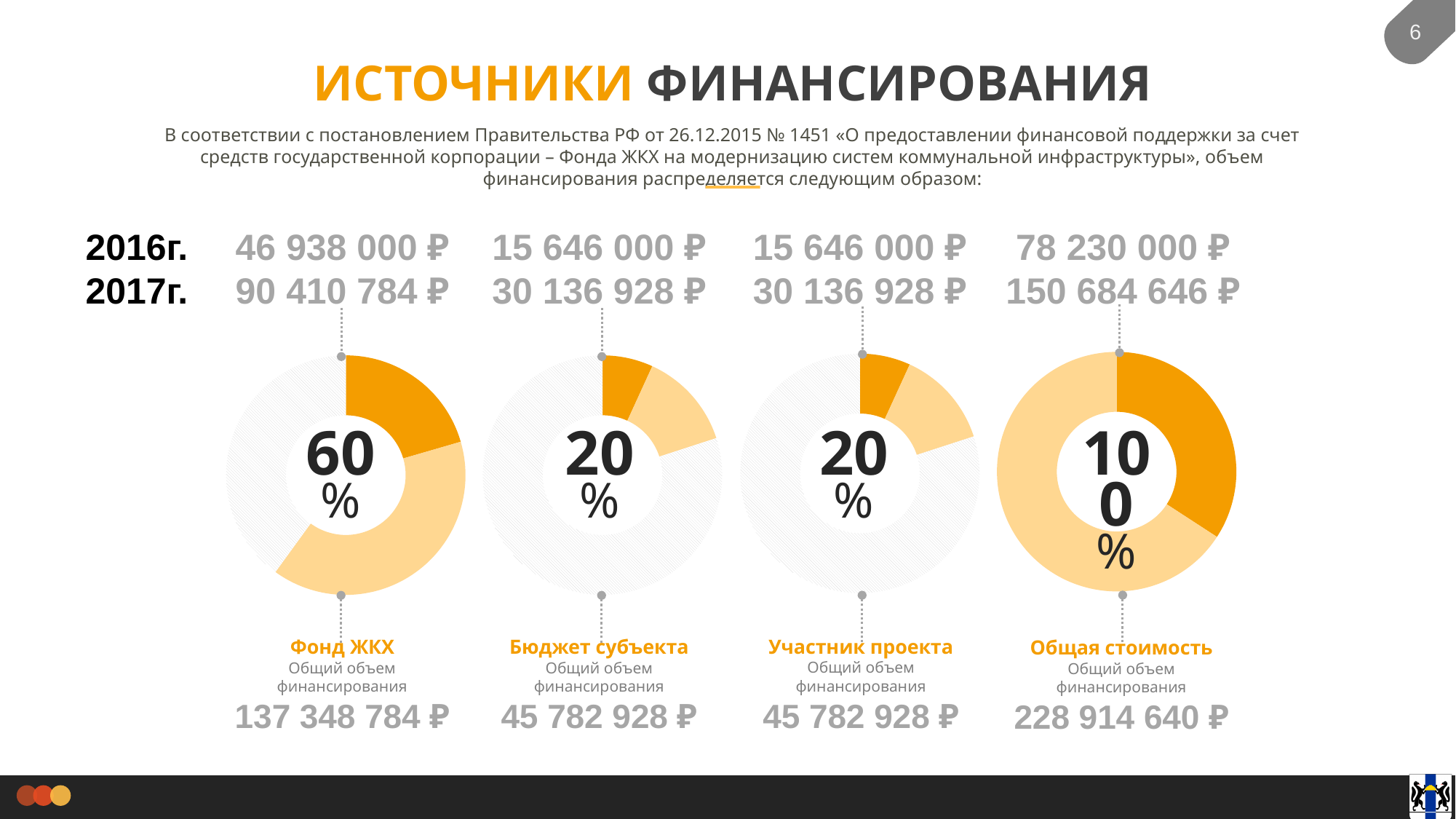
What kind of charts are shown on the slide? Pie (donut) charts In the Фонд ЖКХ chart, what is the value for 2016г.? 46 938 000 ₽ What is the difference between the total financing of Фонд ЖКХ and Бюджет субъекта? 91 565 856 ₽ In the Общая стоимость chart, what is the total volume of financing (Общий объем финансирования)? 228 914 640 ₽ In the Фонд ЖКХ chart, what percentage is shown in the centre? 60% In the Фонд ЖКХ chart, which year has the larger value, 2016г. or 2017г.? 2017г. In the Участник проекта chart, what percentage is shown in the centre? 20% Which funding source has the largest share among Фонд ЖКХ, Бюджет субъекта and Участник проекта? Фонд ЖКХ In the Бюджет субъекта chart, what is the value for 2017г.? 30 136 928 ₽ What is the title of the slide? ИСТОЧНИКИ ФИНАНСИРОВАНИЯ How many donut charts are on the slide? 4 In the Общая стоимость chart, what is the difference between the 2017г. and 2016г. values? 72 454 646 ₽